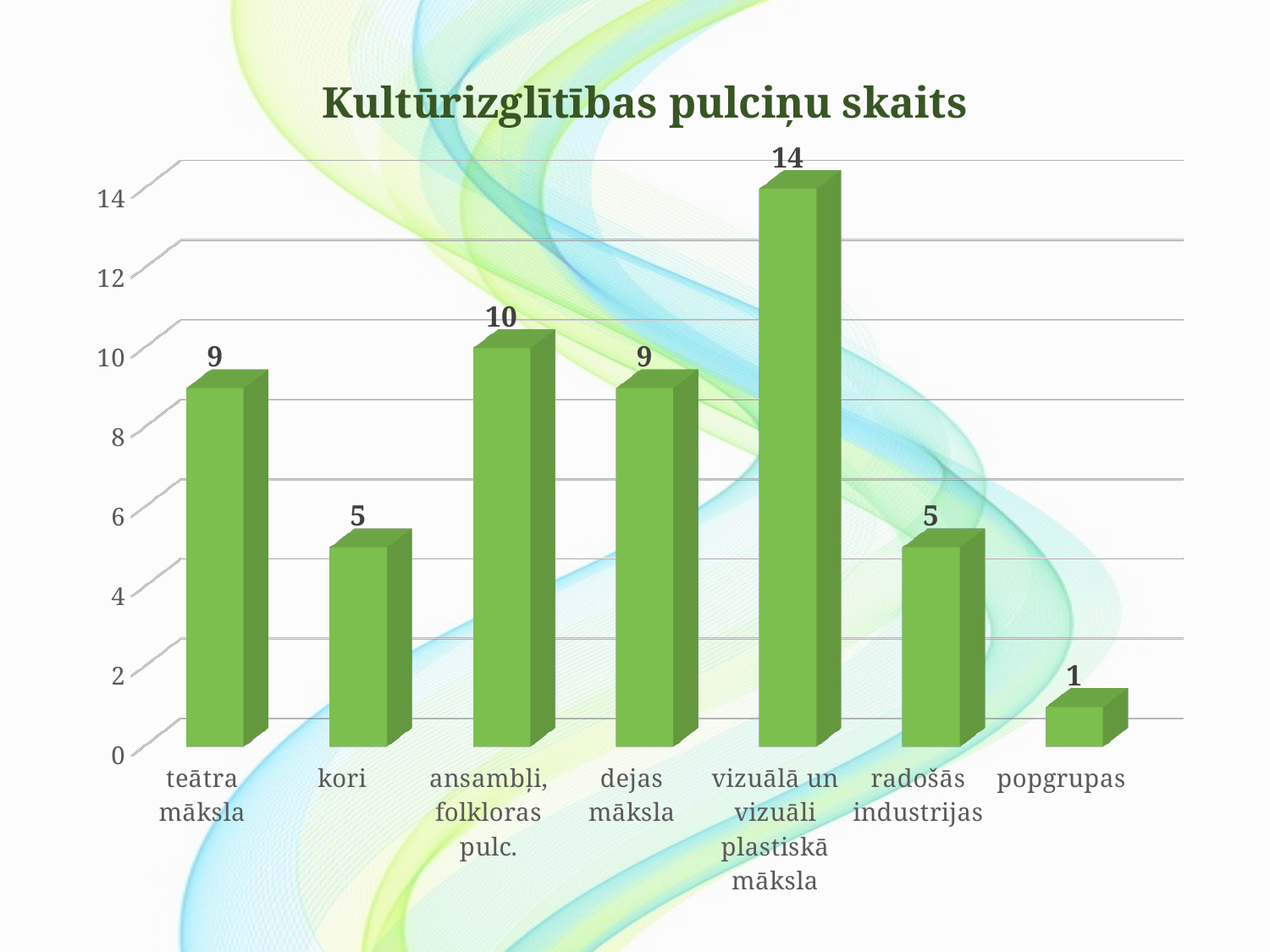
What is the value for ansambļi, folkloras pulc.? 10 Which category has the lowest value? popgrupas Which category has the highest value? vizuālā un vizuāli plastiskā māksla What is the title of the chart? Kultūrizglītības pulciņu skaits What kind of chart is shown on the slide? bar chart What is the value for vizuālā un vizuāli plastiskā māksla? 14 What is the difference between the values for vizuālā un vizuāli plastiskā māksla and dejas māksla? 5 Which is larger, the value for ansambļi, folkloras pulc. or the value for radošās industrijas? ansambļi, folkloras pulc. How many categories are shown on the chart? 7 What is the value for teātra māksla? 9 What is the value for popgrupas? 1 What is the value for kori? 5